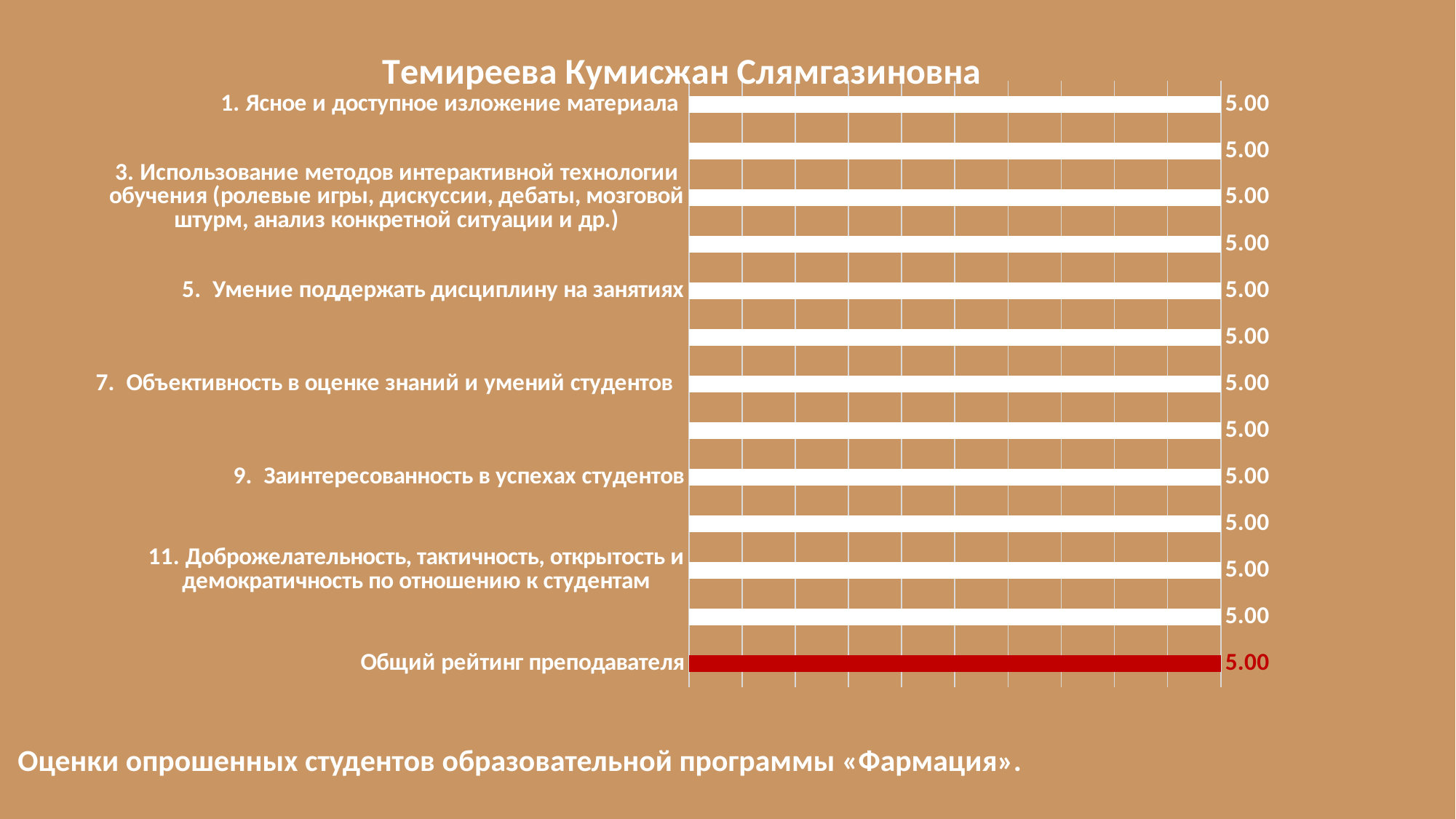
What is the title of the chart? Темиреева Кумисжан Слямгазиновна What is the value for "Общий рейтинг преподавателя"? 5.00 What colour is the bar for "Общий рейтинг преподавателя"? Red What is the value for "9. Заинтересованность в успехах студентов"? 5.00 What is the value for "1. Ясное и доступное изложение материала"? 5.00 What is the value for "7. Объективность в оценке знаний и умений студентов"? 5.00 What is the value for "5. Умение поддержать дисциплину на занятиях"? 5.00 What is the value for "11. Доброжелательность, тактичность, открытость и демократичность по отношению к студентам"? 5.00 What is the value for "3. Использование методов интерактивной технологии обучения"? 5.00 What kind of chart is shown on the slide? Bar chart How many bars are plotted in the chart? 13